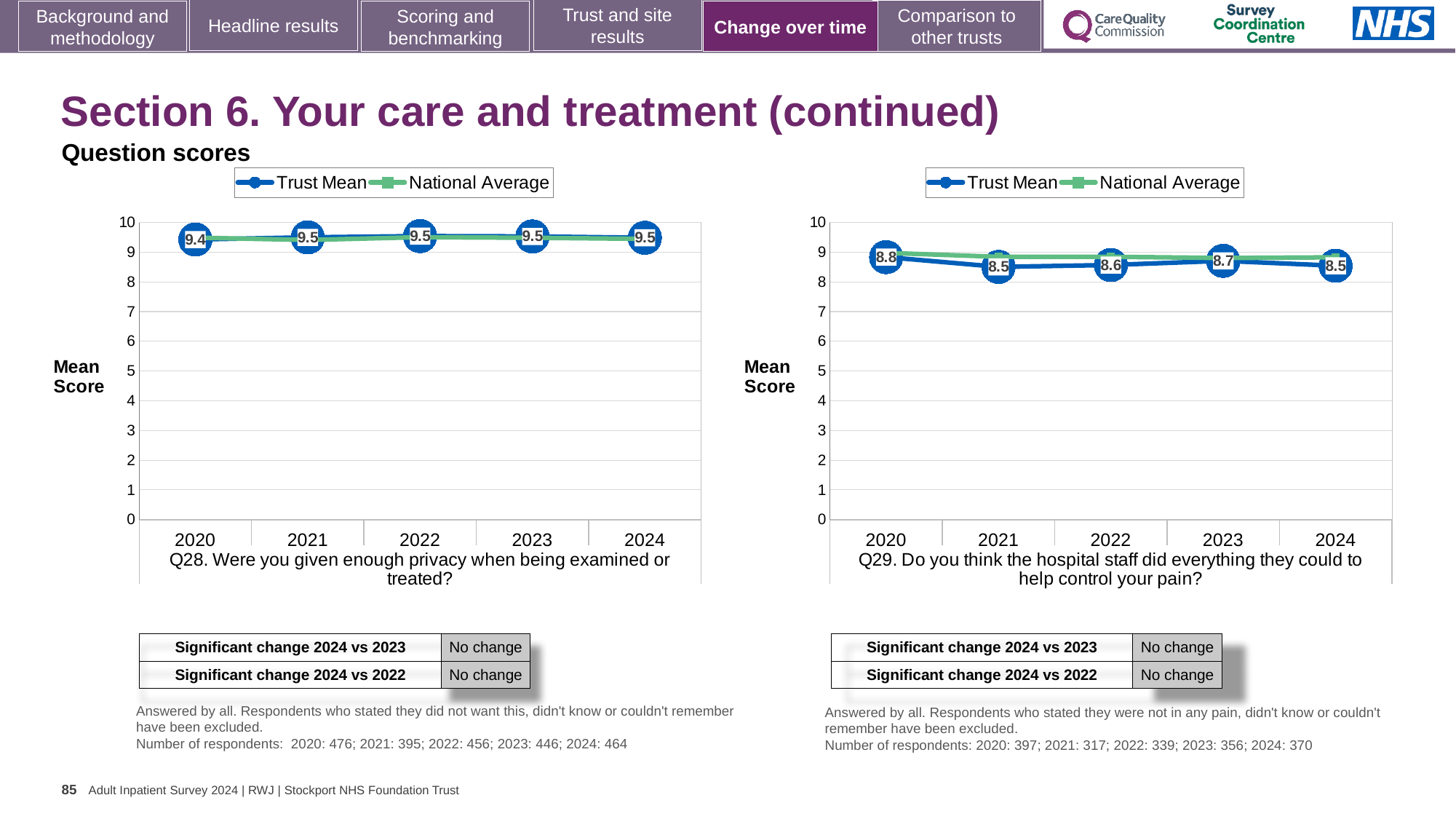
In the Q28 chart (left), what is the Trust Mean score for 2024? 9.5 What are the two series named in the legend of the Q28 chart (left)? Trust Mean and National Average What kind of chart is the Q28 chart (left)? line chart How many series does the legend of the Q29 chart (right) list? 2 In the Q29 chart (right), what is the difference between the Trust Mean scores for 2020 and 2024? 0.3 In the Q29 chart (right), which year has the highest Trust Mean score? 2020 In the Q29 chart (right), is the Trust Mean score for 2022 larger or smaller than the score for 2023? smaller In the Q29 chart (right), what is the Trust Mean score for 2020? 8.8 In the Q28 chart (left), is the Trust Mean value for 2021 greater or less than 9? greater How many years are plotted on the x axis of the Q28 chart (left)? 5 In the Q29 chart (right), what is the Trust Mean score for 2023? 8.7 In the Q28 chart (left), what is the Trust Mean score for 2020? 9.4